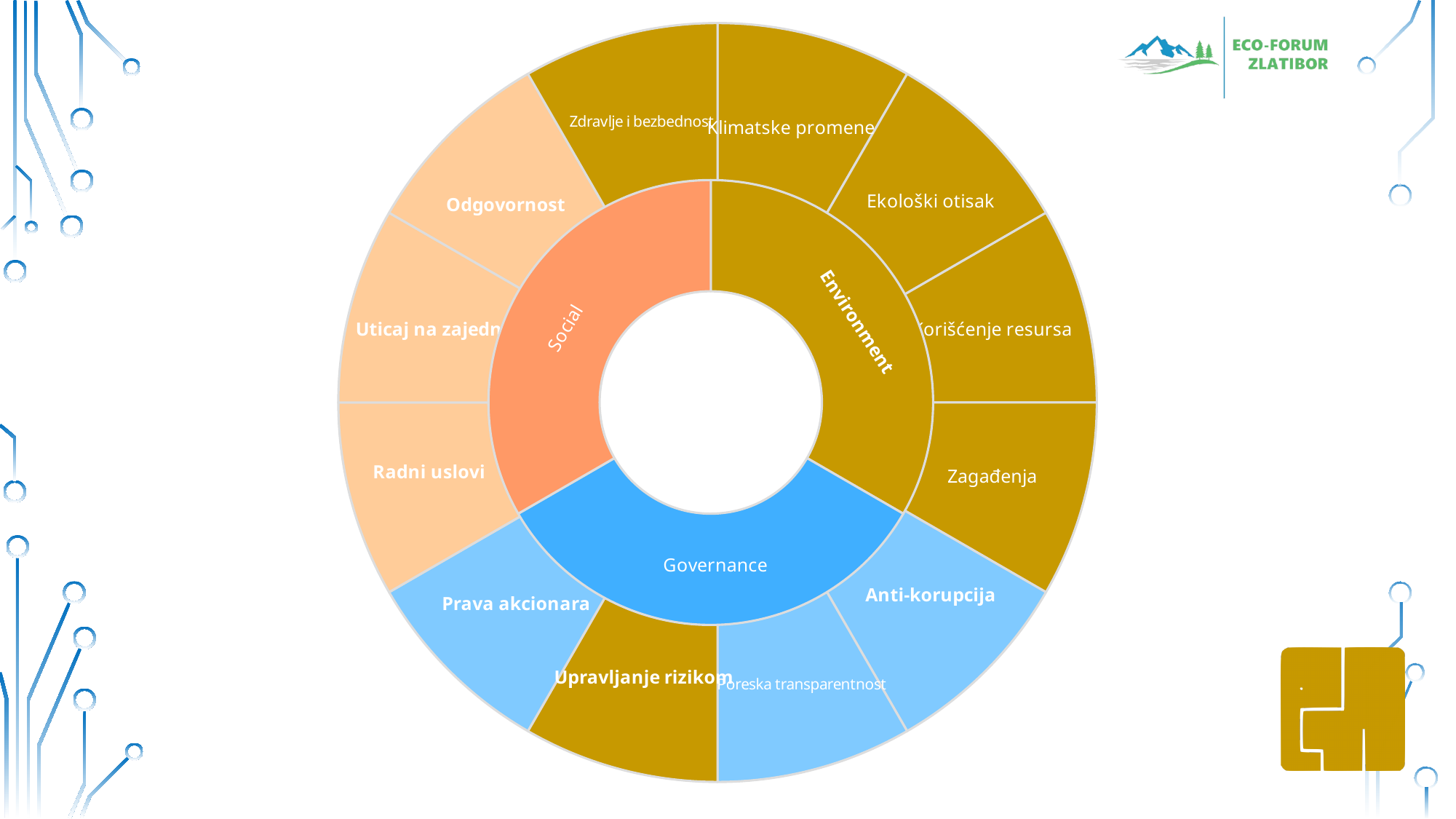
Which inner-ring category does the segment 'Zagađenja' belong to? Environment Which inner-ring category does the segment 'Upravljanje rizikom' belong to? Governance Which inner-ring category does the segment 'Anti-korupcija' belong to? Governance Which inner-ring category does the segment 'Radni uslovi' belong to? Social How many outer-ring segments belong to the Environment category? 4 How many categories are in the inner ring of the chart? 3 What colour is used for the Governance category in the chart? Blue What colour is used for the Social category in the chart? Orange How many outer-ring segments belong to the Governance category? 4 What kind of chart is shown on the slide? Sunburst chart